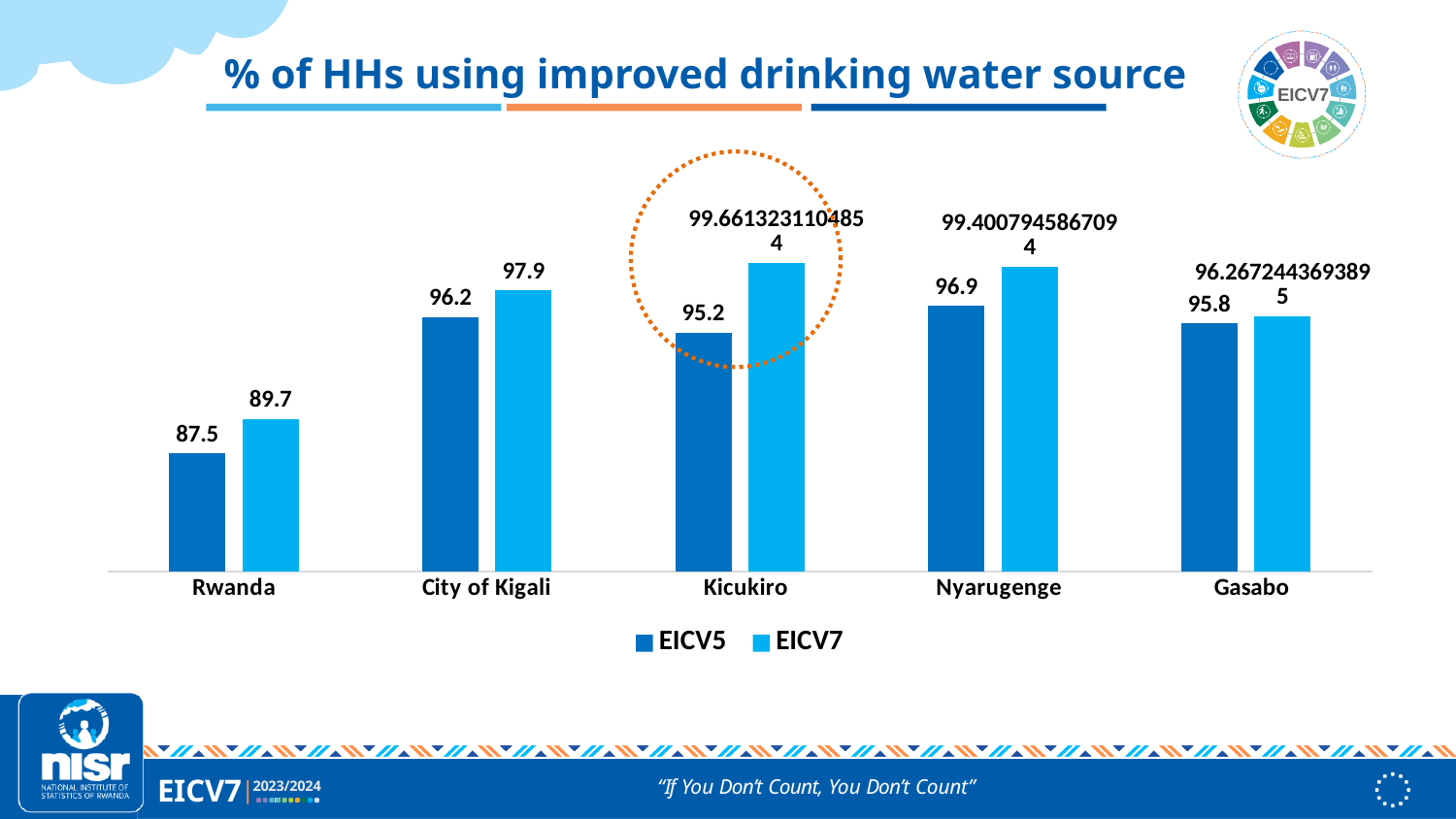
What is the EICV5 value for Kicukiro? 95.2 How many categories are shown on the x axis? 5 What is the EICV7 value for Rwanda? 89.7 What is the EICV5 value for Nyarugenge? 96.9 What is the EICV7 value for City of Kigali? 97.9 How many series does the legend list? 2 What is the EICV5 value for Rwanda? 87.5 What type of chart is shown on the slide? bar chart Which category has the highest EICV5 value? Nyarugenge What is the difference between the EICV7 and EICV5 values for Rwanda? 2.2 What is the EICV5 value for Gasabo? 95.8 Which category has the lowest EICV5 value? Rwanda